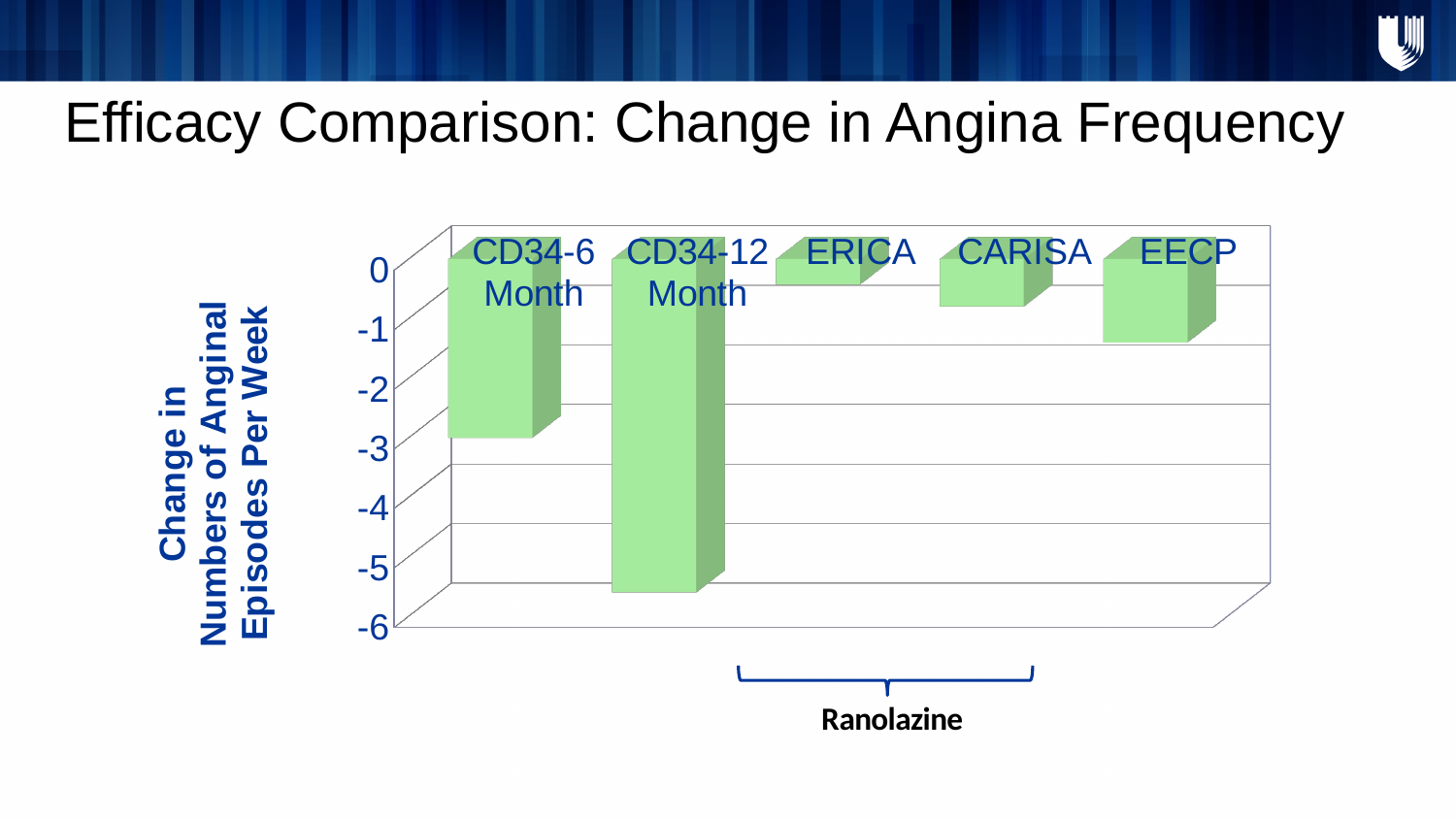
Which category shows the largest decrease in anginal episodes per week (the most negative value)? CD34-12 Month Is the value for ERICA greater or less than -1? greater Which shows a larger decrease in anginal episodes per week, CARISA or EECP? EECP Is the value for CD34-12 Month greater or less than -4? less What is the title of the vertical axis? Change in Numbers of Anginal Episodes Per Week Which shows a larger decrease in anginal episodes per week, CD34-6 Month or CD34-12 Month? CD34-12 Month How many categories are plotted in the chart? 5 Which category shows the smallest change in anginal episodes per week (the value closest to 0)? ERICA Is the value for EECP greater or less than -2? greater What type of chart is shown on the slide? bar chart Which drug label is shown under the bracket grouping the ERICA and CARISA bars? Ranolazine